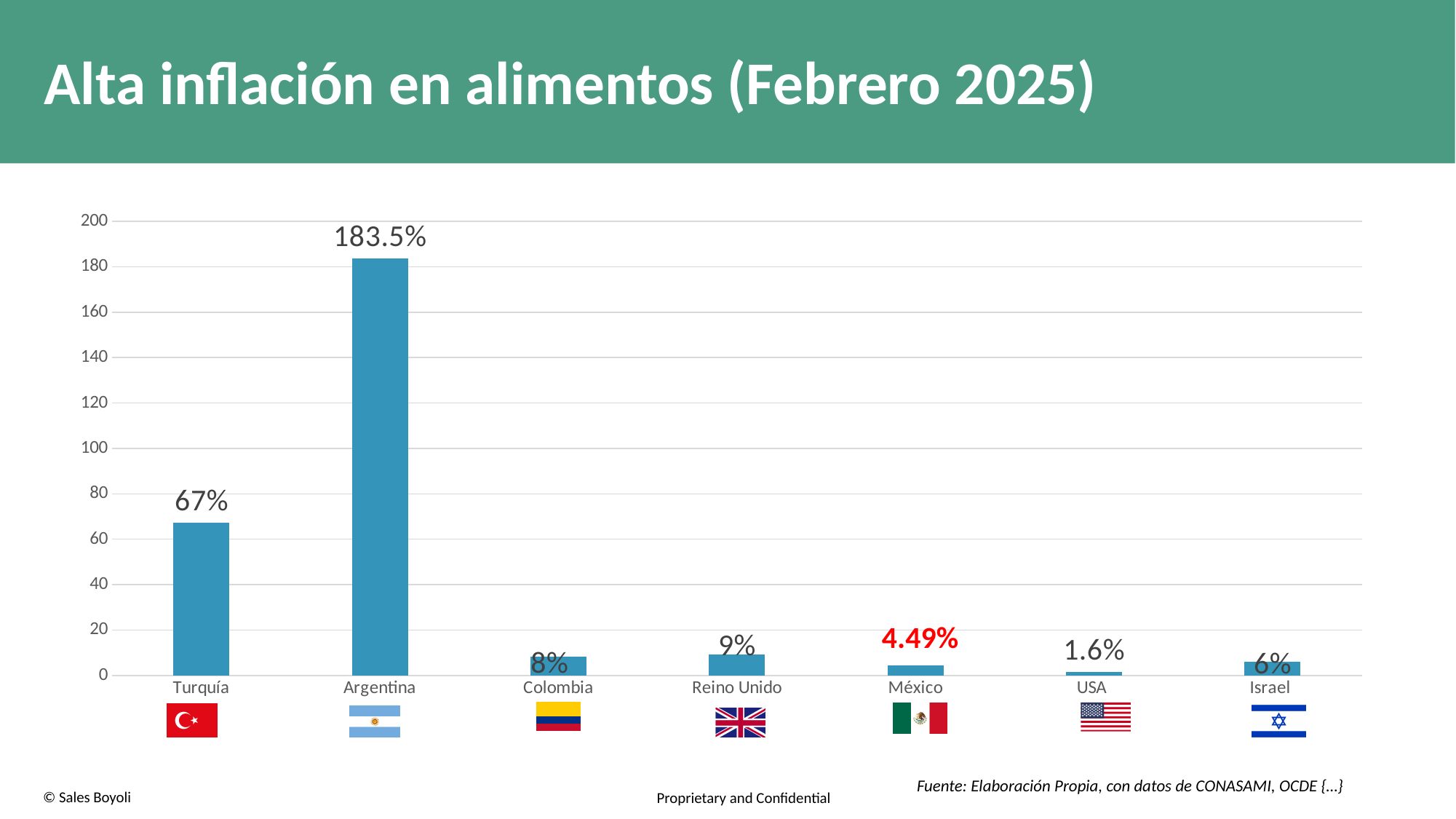
Which country has the highest value on the chart? Argentina Which country's data label is shown in red? México What is the value shown for USA? 1.6% How many countries are shown on the chart? 7 Which country has the lowest value on the chart? USA What is the difference between the values for Argentina and Turquía? 116.5% What is the value shown for México? 4.49% What kind of chart is shown on the slide? Bar chart Is the value for Turquía greater or less than 60? greater What is the food inflation value shown for Argentina? 183.5% Which has a larger value, Reino Unido or Colombia? Reino Unido What is the value shown for Turquía? 67%